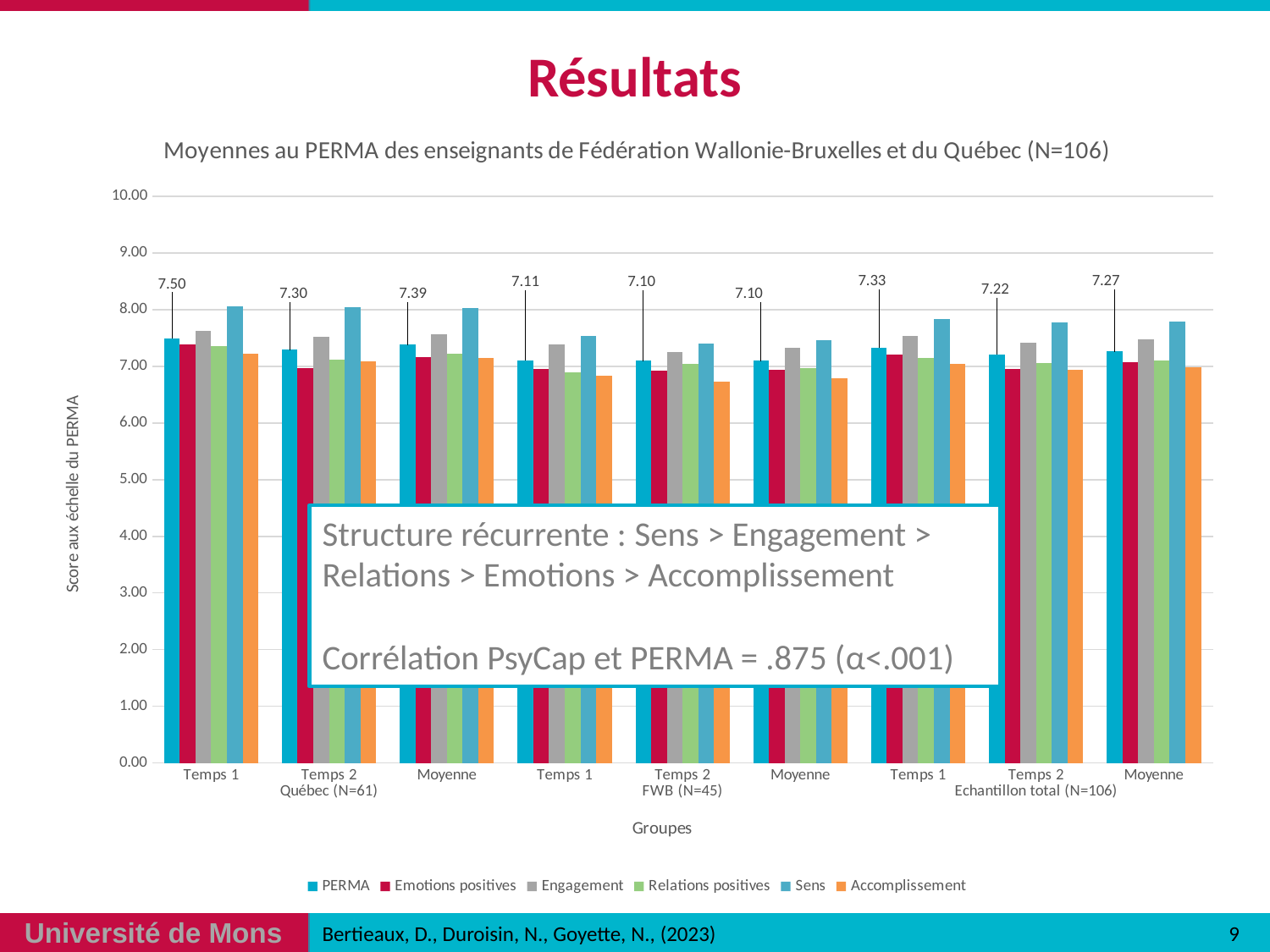
How many series does the legend list? 6 What is the PERMA value for Temps 1 in the Québec (N=61) group? 7.50 What kind of chart is shown on the slide? Bar chart What is the difference between the PERMA values for Temps 1 and Temps 2 in the Québec (N=61) group? 0.20 Within the Echantillon total (N=106) group, which time point has the lowest PERMA value? Temps 2 What is the PERMA value for Moyenne in the Echantillon total (N=106) group? 7.27 Is the Accomplissement value for Temps 2 in the FWB (N=45) group greater or less than 7.00? less What is the difference between the PERMA values for Temps 1 and Temps 2 in the Echantillon total (N=106) group? 0.11 Which group has the highest labelled PERMA value? Temps 1, Québec (N=61) How many groups are shown along the x axis? 9 Which is larger, the PERMA Moyenne for Québec (N=61) or the PERMA Moyenne for FWB (N=45)? Québec (N=61) What is the PERMA value for Temps 1 in the FWB (N=45) group? 7.11